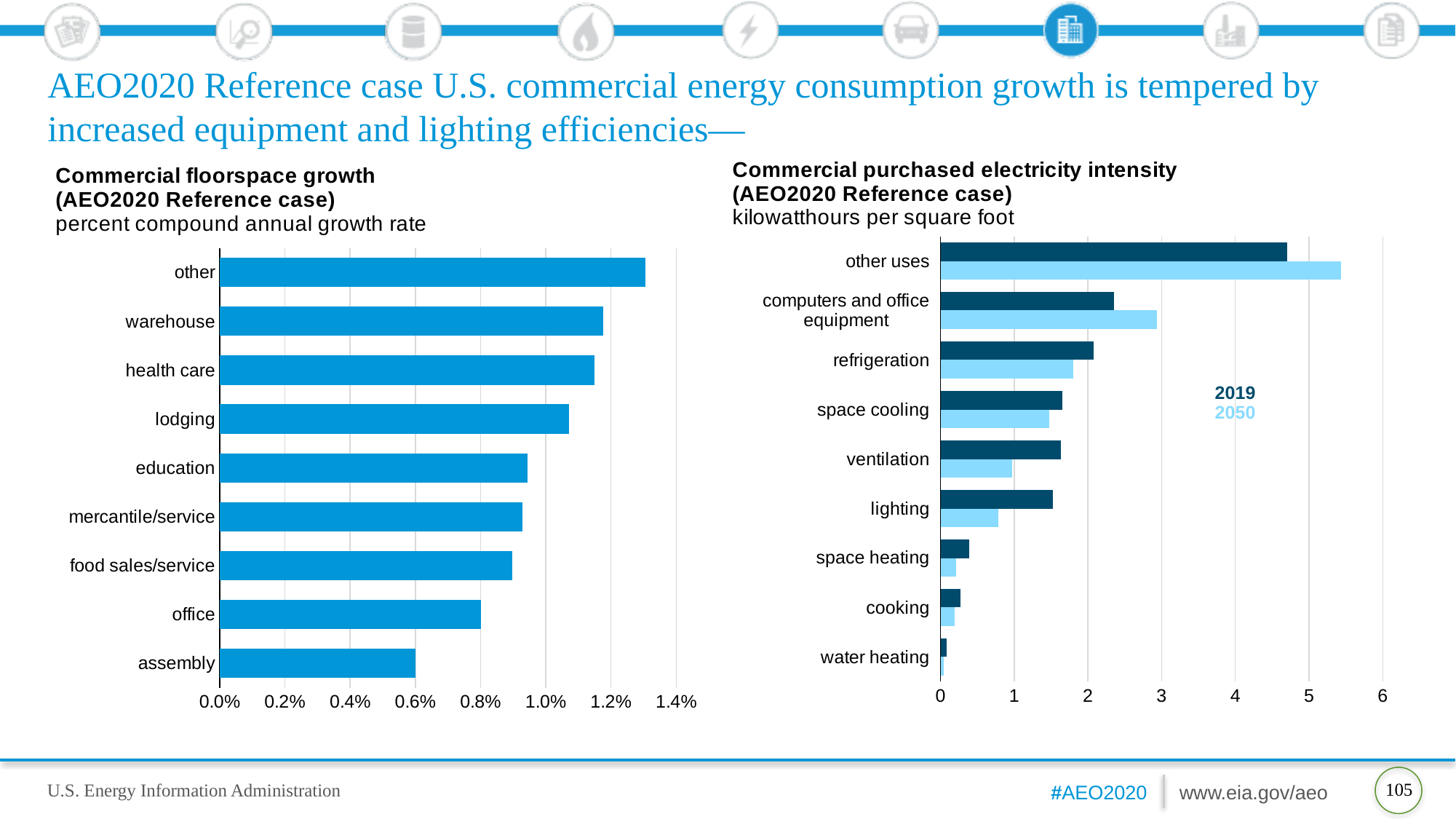
In the 'Commercial purchased electricity intensity' chart, is the 2050 value for other uses greater or less than 5? greater In the 'Commercial floorspace growth' chart, which category has the lowest growth rate? assembly What kind of chart is the 'Commercial floorspace growth' chart on the left? bar chart How many series does the legend list in the 'Commercial purchased electricity intensity' chart? 2 In the 'Commercial floorspace growth' chart, which is larger, the value for warehouse or the value for office? warehouse In the 'Commercial floorspace growth' chart, which category has the highest growth rate? other In the 'Commercial purchased electricity intensity' chart, which is larger for lighting, the 2019 value or the 2050 value? 2019 In the 'Commercial purchased electricity intensity' chart, which end use has the highest 2050 value? other uses In the 'Commercial floorspace growth' chart, is the value for lodging greater or less than 1.0%? greater In the 'Commercial floorspace growth' chart, is the value for education greater or less than 1.0%? less How many building categories are shown in the 'Commercial floorspace growth' chart? 9 In the 'Commercial purchased electricity intensity' chart, which end use has the lowest 2019 value? water heating